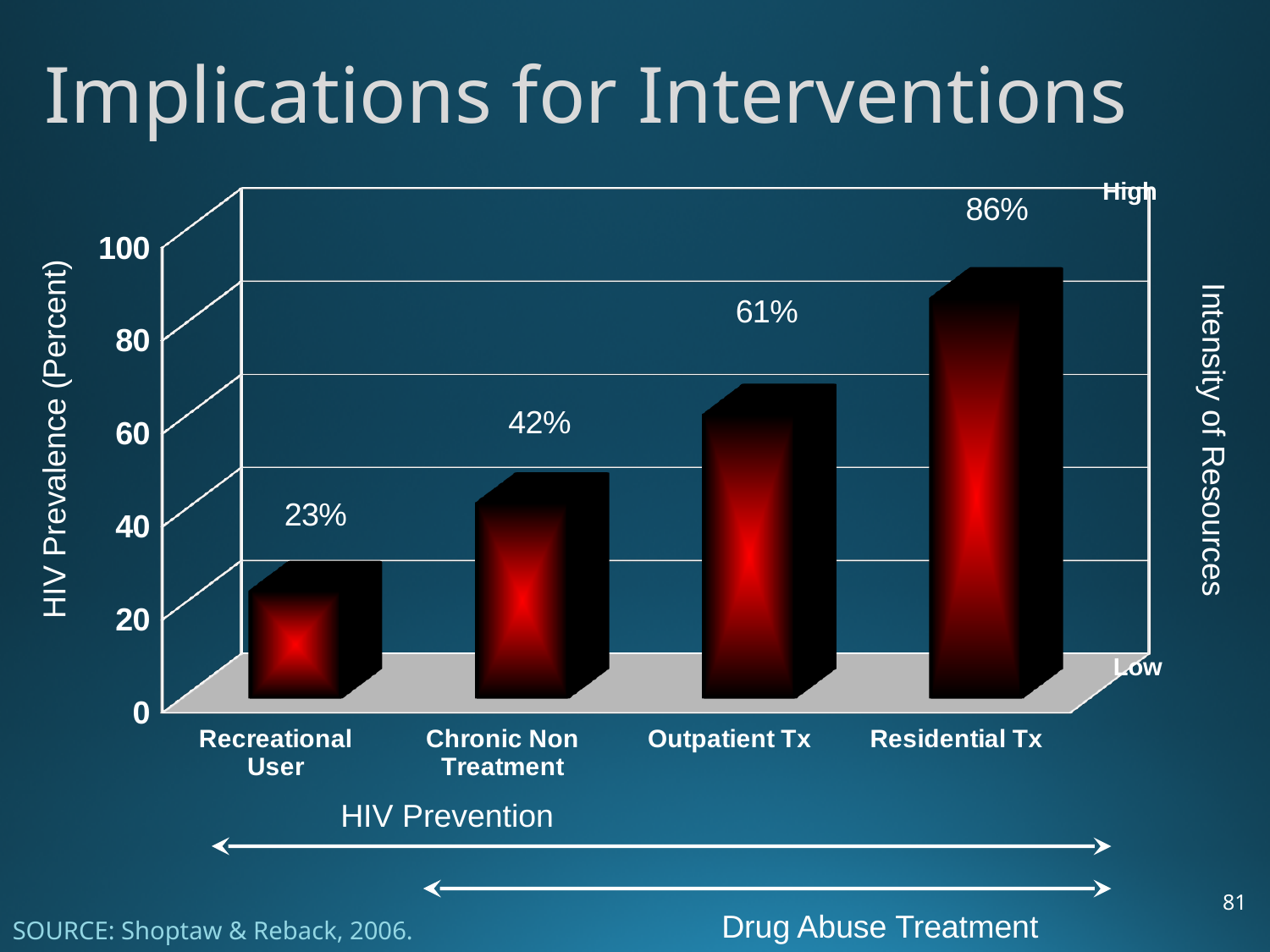
How many categories are shown on the x axis? 4 What is the HIV prevalence for Residential Tx? 86% Do the values rise or fall from left to right along the x axis? Rise What is the difference in HIV prevalence between Residential Tx and Recreational User? 63% Which category has the lowest HIV prevalence? Recreational User What kind of chart is shown on the slide? Bar chart What is the HIV prevalence for Chronic Non Treatment? 42% What is the difference in HIV prevalence between Outpatient Tx and Chronic Non Treatment? 19% Which category has the highest HIV prevalence? Residential Tx Which has a higher HIV prevalence, Chronic Non Treatment or Outpatient Tx? Outpatient Tx What is the HIV prevalence for Recreational User? 23% What is the HIV prevalence for Outpatient Tx? 61%